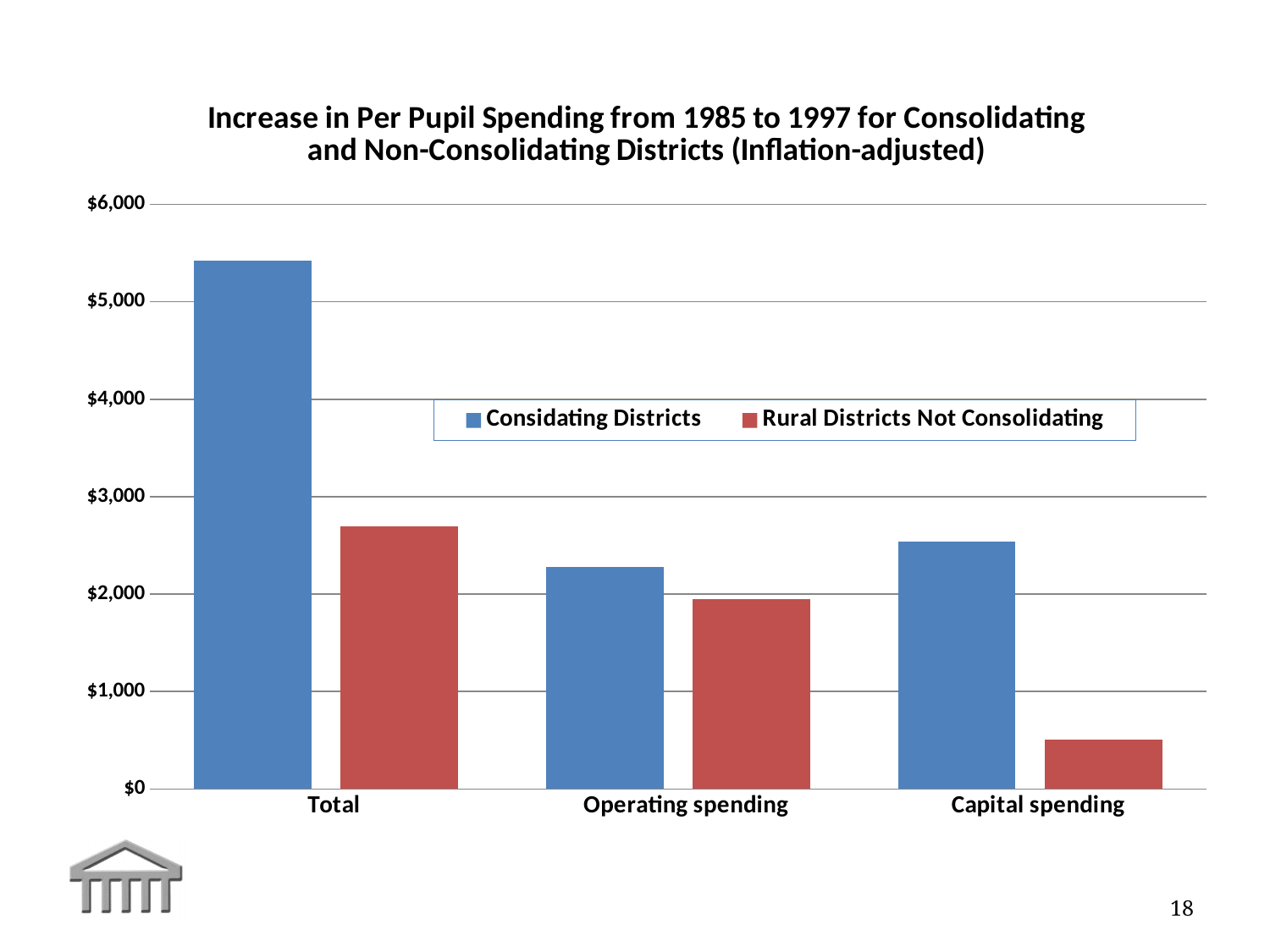
What colour are the bars for Rural Districts Not Consolidating? Red In the Capital spending category, which series has the larger value? Considating Districts Is the value for Considating Districts in the Capital spending category greater or less than $2,000? greater Is the value for Rural Districts Not Consolidating in the Capital spending category greater or less than $1,000? less Is the value for Rural Districts Not Consolidating in the Total category greater or less than $3,000? less Which category and series has the shortest bar in the chart? Rural Districts Not Consolidating, Capital spending In the Operating spending category, which series has the larger value? Considating Districts What kind of chart is shown on the slide? Bar chart How many categories are shown on the x axis? 3 How many series does the legend list? 2 Which category and series has the tallest bar in the chart? Considating Districts, Total